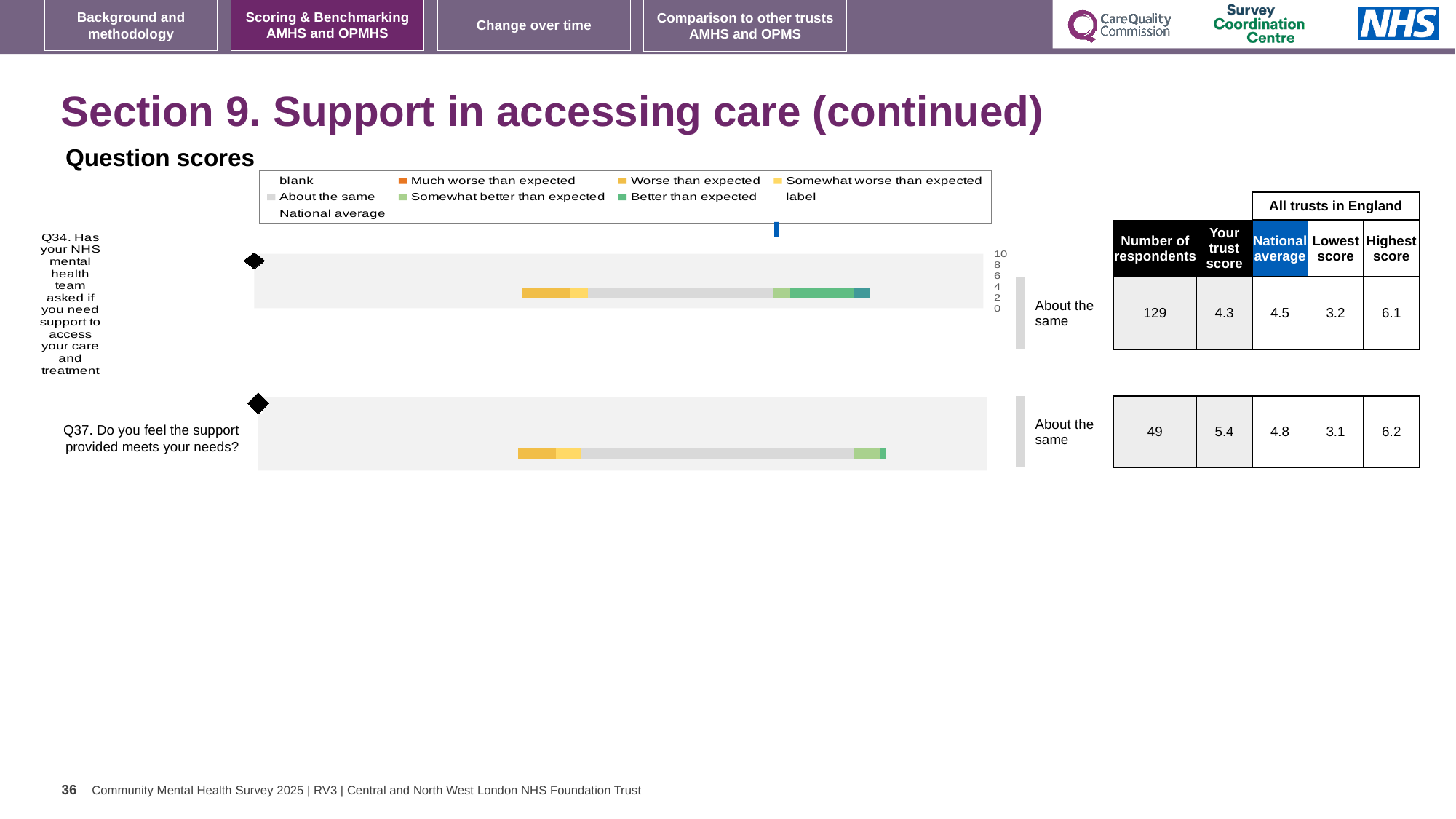
How many respondents answered Q37? 49 For Q37, which is larger: the trust score or the national average? Trust score What is the national average score for Q34? 4.5 What is the trust score for Q37 (Do you feel the support provided meets your needs)? 5.4 Which question has the higher trust score, Q34 or Q37? Q37 What is the difference between the highest score and the lowest score for Q34? 2.9 Which benchmark category is Q34 placed in? About the same What kind of chart is used to show the question scores on this slide? Bar chart What colour does the legend use for 'Much worse than expected'? Orange By how much does the trust score for Q37 exceed the national average for Q37? 0.6 What is the trust score for Q34 (Has your NHS mental health team asked if you need support to access your care and treatment)? 4.3 How many questions are plotted in the chart on this slide? 2